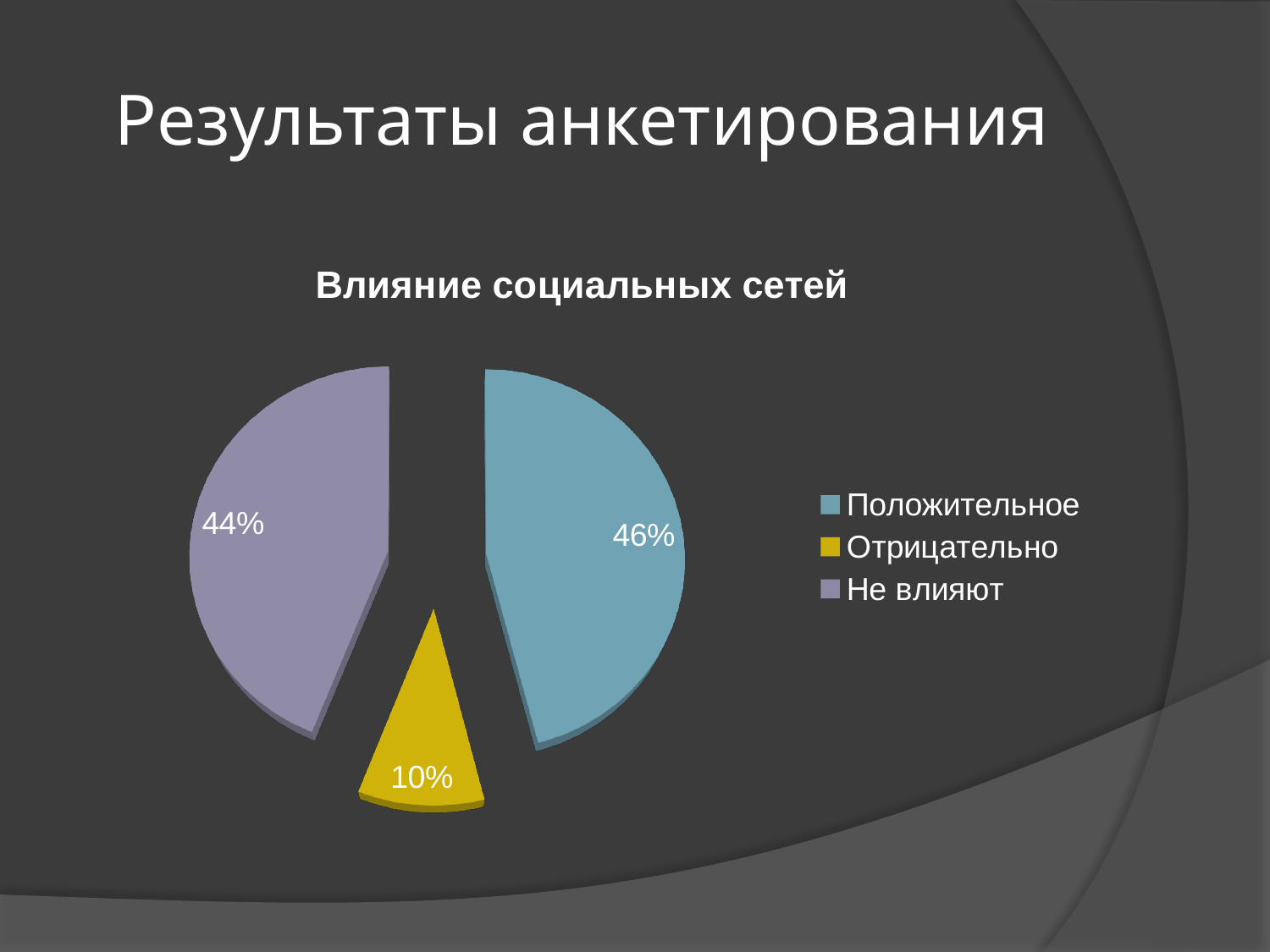
Which category has the largest slice? Положительное What share of the pie does Отрицательно have? 10% What is the difference in percentage points between Положительное and Отрицательно? 36 What kind of chart is shown on the slide? Pie chart What colour is the Отрицательно slice? Yellow What is the title of the chart? Влияние социальных сетей Which category has the smallest slice? Отрицательно How many slices does the pie chart have? 3 What share of the pie does Не влияют have? 44% What is the difference in percentage points between Не влияют and Отрицательно? 34 Which is larger, Не влияют or Отрицательно? Не влияют What share of the pie does Положительное have? 46%